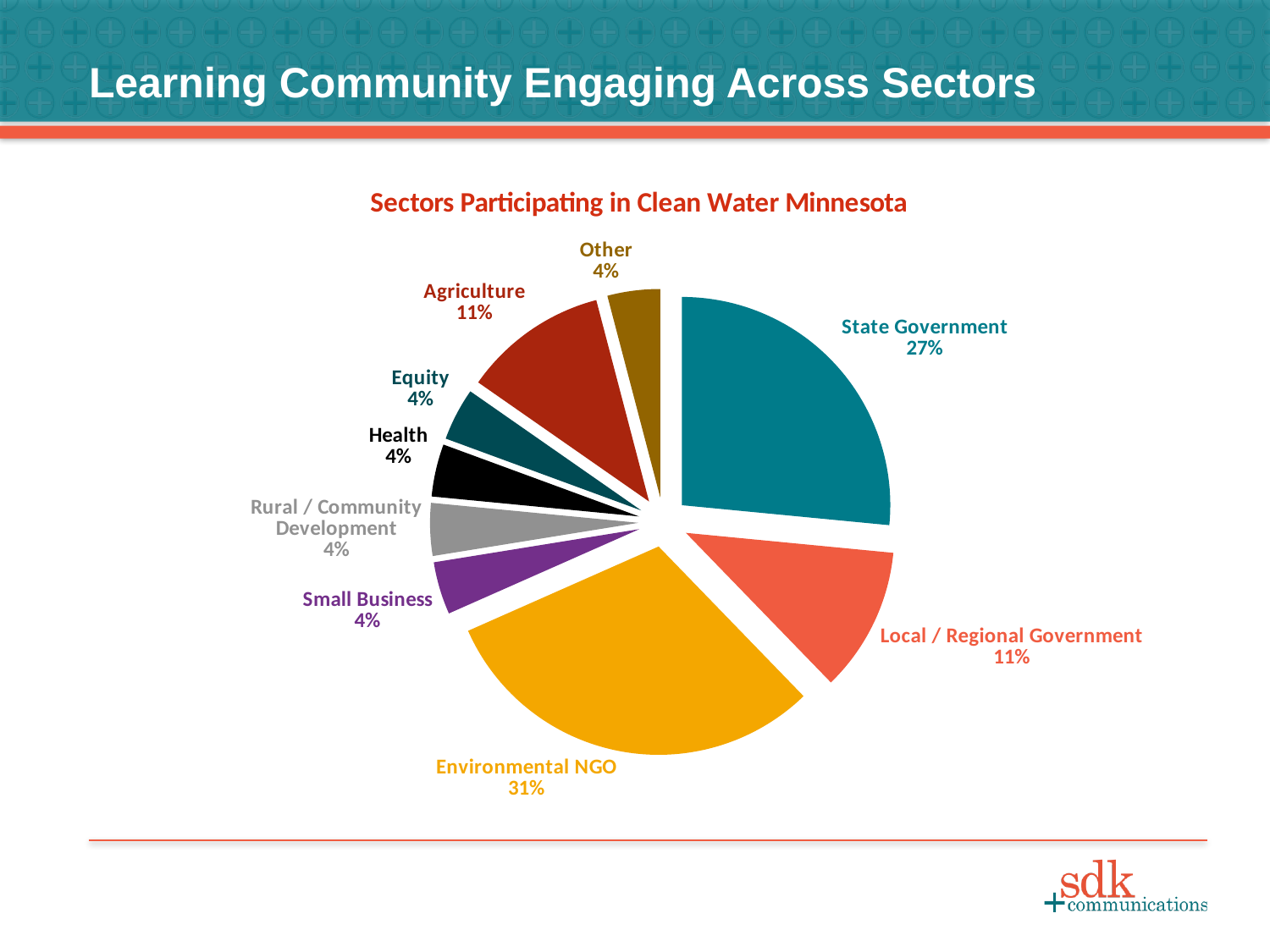
How many sectors (slices) are shown in the pie chart? 9 What is the difference between the Environmental NGO share and the State Government share? 4% Which sector has the largest share of the pie? Environmental NGO What is the value shown for Agriculture? 11% What is the title of the chart? Sectors Participating in Clean Water Minnesota What colour is the Environmental NGO slice? yellow/orange What is the value shown for Local / Regional Government? 11% Which is larger, the share for State Government or the share for Agriculture? State Government What share of the pie does State Government represent? 27% What type of chart is shown on the slide? pie chart What share of the pie does Environmental NGO represent? 31% What is the value shown for Small Business? 4%